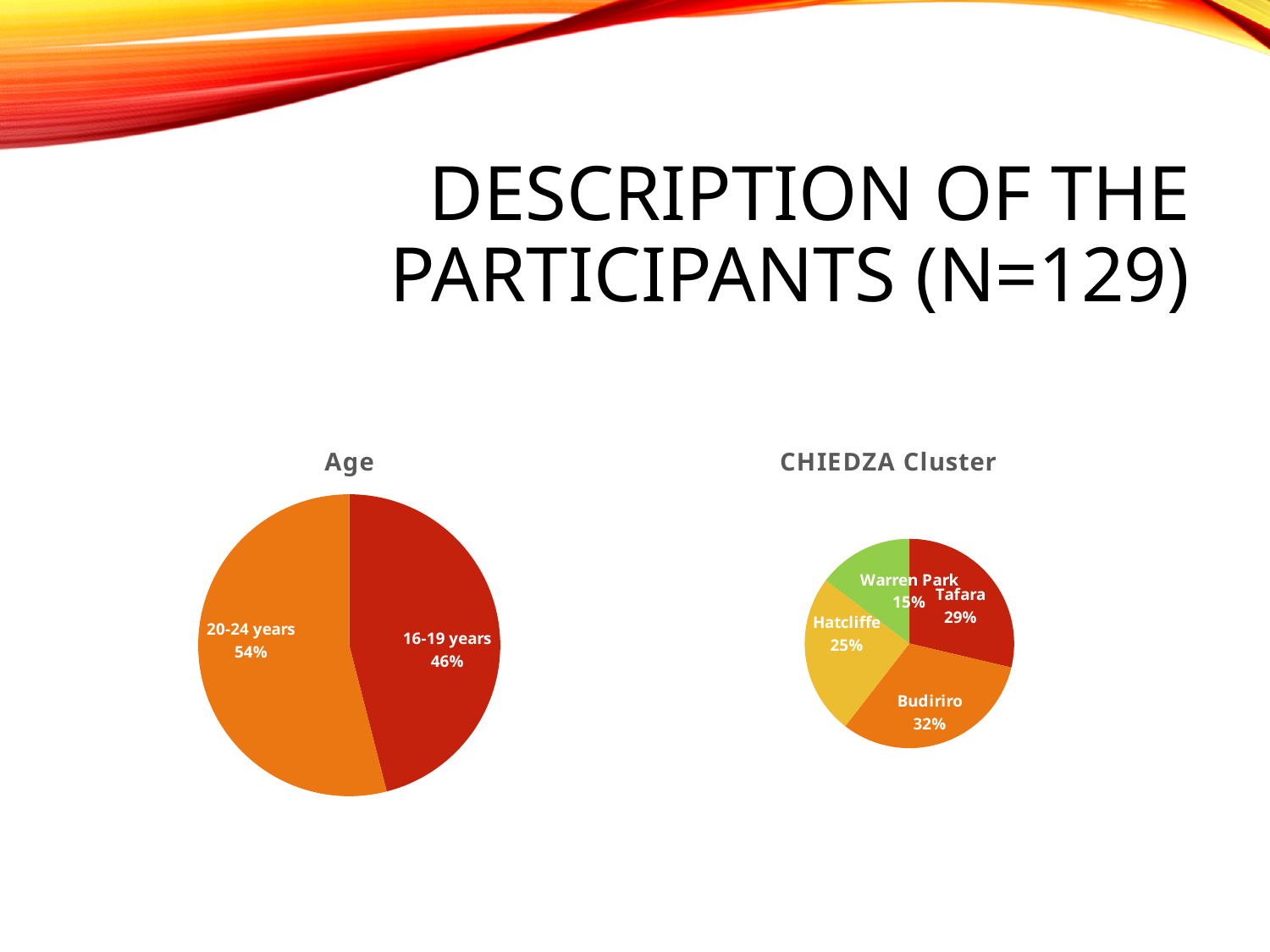
In the Age chart, what share of participants are 16-19 years? 46% In the CHIEDZA Cluster chart, which cluster has the largest share? Budiriro In the CHIEDZA Cluster chart, what share of participants are from Warren Park? 15% In the Age chart, what share of participants are 20-24 years? 54% In the Age chart, which age group has the larger share? 20-24 years In the CHIEDZA Cluster chart, what is the difference in percentage points between Budiriro and Warren Park? 17 In the Age chart, what is the difference in percentage points between the 20-24 years and 16-19 years slices? 8 How many clusters are shown in the CHIEDZA Cluster chart? 4 In the CHIEDZA Cluster chart, what share of participants are from Budiriro? 32% What type of chart is the Age chart? Pie chart In the CHIEDZA Cluster chart, which has the larger share, Tafara or Hatcliffe? Tafara In the CHIEDZA Cluster chart, which cluster has the smallest share? Warren Park